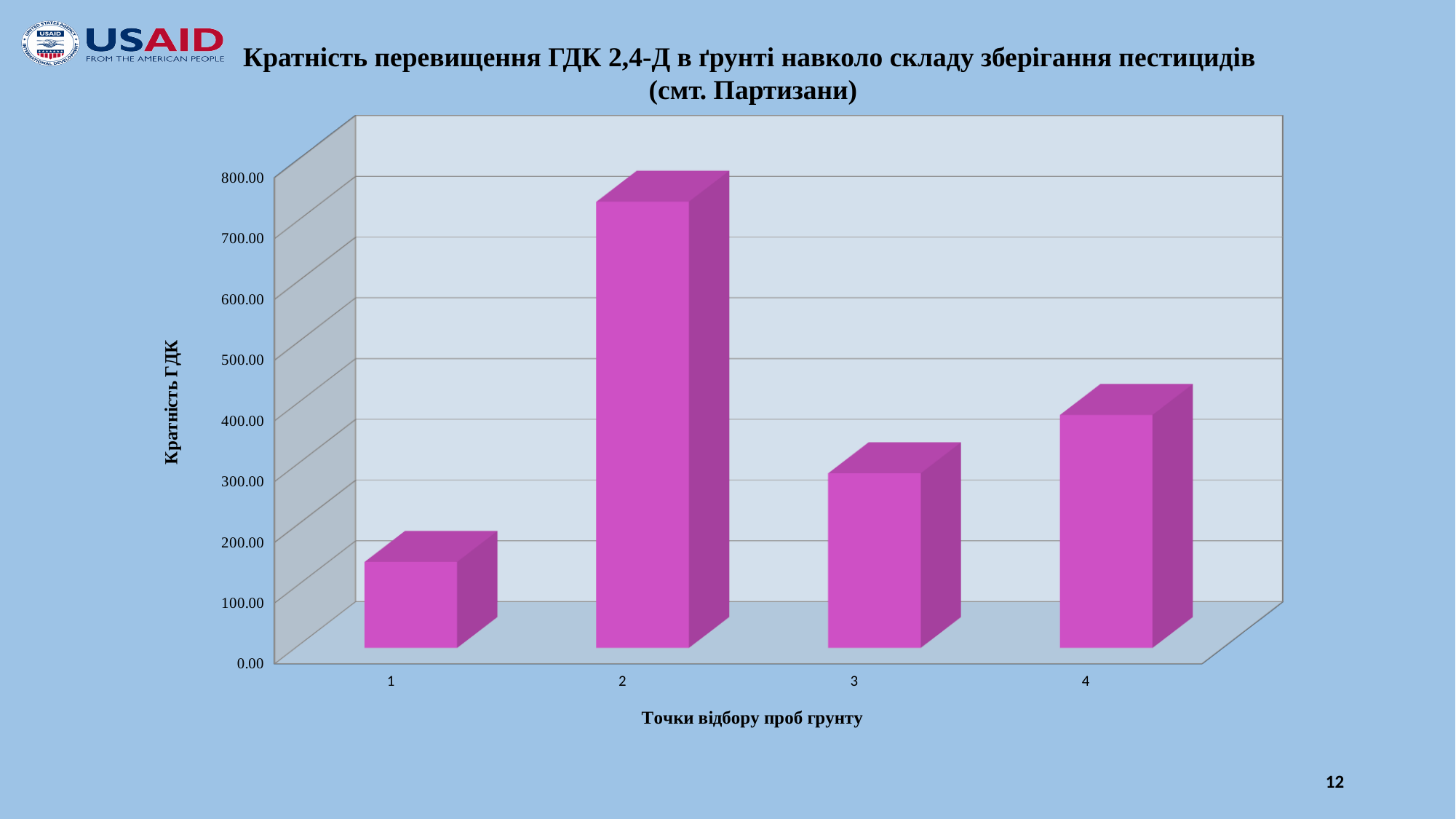
Which sampling point has the lowest value? 1 What kind of chart is shown on the slide? bar chart Is the value for sampling point 3 greater or less than 400? less How many sampling points (categories) are shown on the x axis? 4 What is the title of the horizontal axis? Точки відбору проб грунту Which has the larger value, sampling point 3 or sampling point 4? 4 Is the value for sampling point 1 greater or less than 200? less Which has the larger value, sampling point 2 or sampling point 4? 2 What is the title of the vertical axis? Кратність ГДК Is the value for sampling point 2 greater or less than 700? greater Which sampling point has the highest value? 2